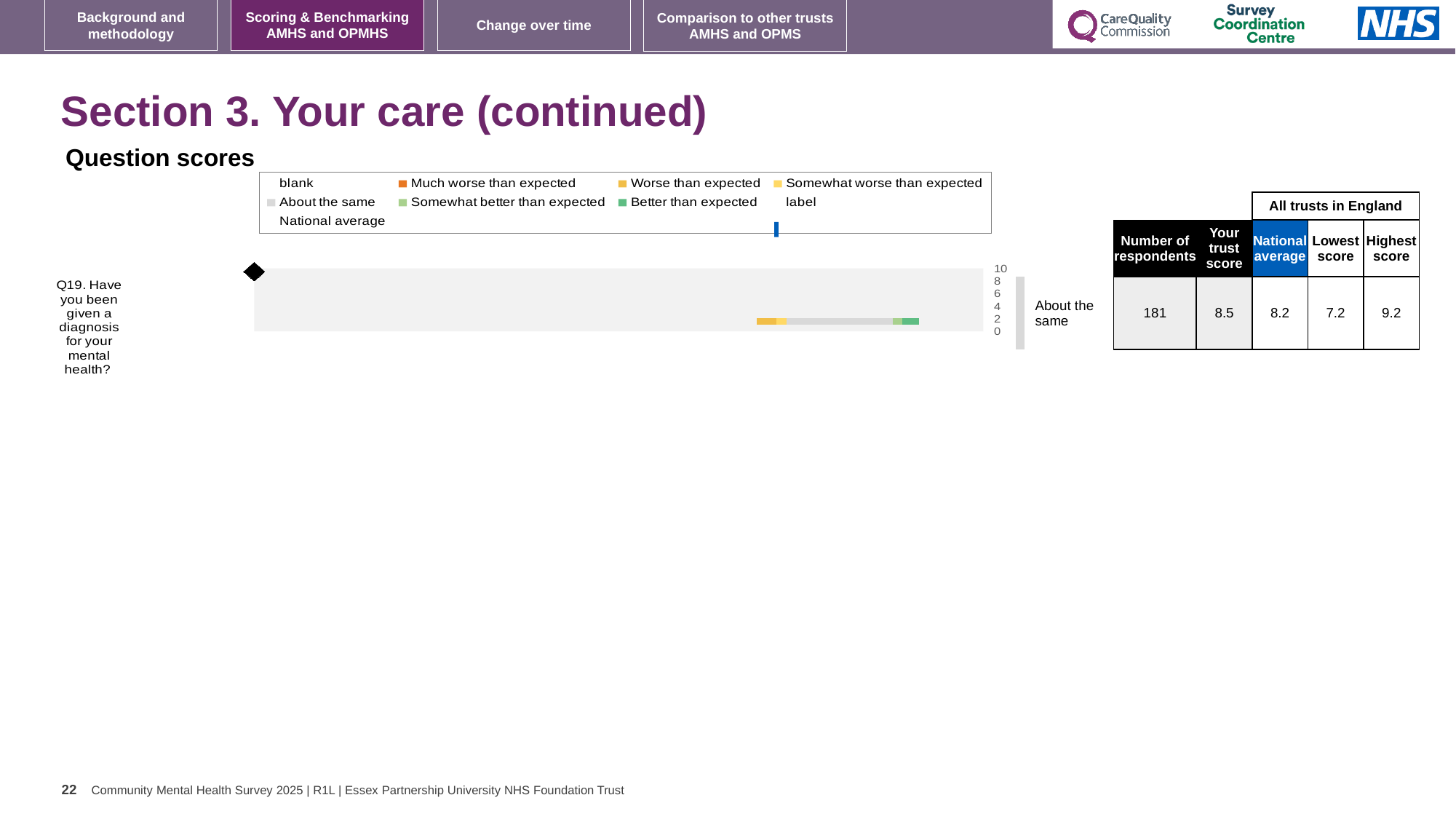
What is the highest score among all trusts in England for Q19? 9.2 What is the trust's score for Q19 (Have you been given a diagnosis for your mental health?)? 8.5 For Q19, which is larger: the trust's score or the national average? Your trust score (8.5) How many respondents answered Q19? 181 What benchmark category label is shown next to the Q19 bar? About the same What is the lowest score among all trusts in England for Q19? 7.2 What is the national average score for Q19? 8.2 What is the difference between the highest and lowest trust scores for Q19? 2.0 What kind of chart is used to show the Q19 question score? bar chart How many questions are plotted in the Question scores chart? 1 By how much does the trust's score for Q19 exceed the national average? 0.3 What colour represents 'Better than expected' in the chart legend? green